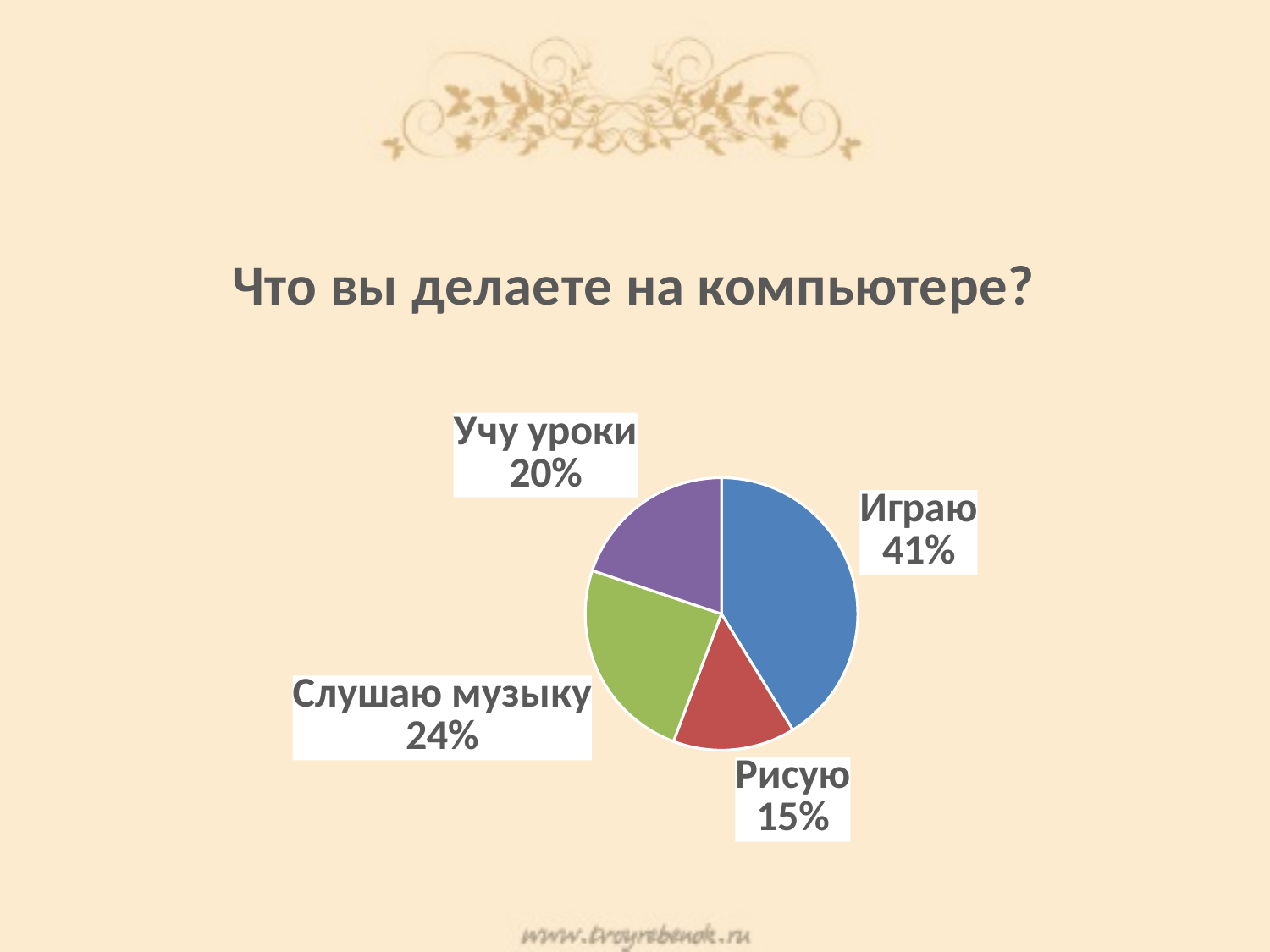
What is the difference between "Играю" and "Рисую"? 26% How many slices does the pie chart have? 4 What is the value for "Учу уроки"? 20% What is the value for "Рисую"? 15% Which category has the largest slice? Играю What kind of chart is shown on the slide? pie chart Which category has the smallest slice? Рисую What is the title of the chart? Что вы делаете на компьютере? Which is larger, "Слушаю музыку" or "Учу уроки"? Слушаю музыку What share of the pie does "Играю" take? 41% What is the value for "Слушаю музыку"? 24% What colour is the "Играю" slice? blue